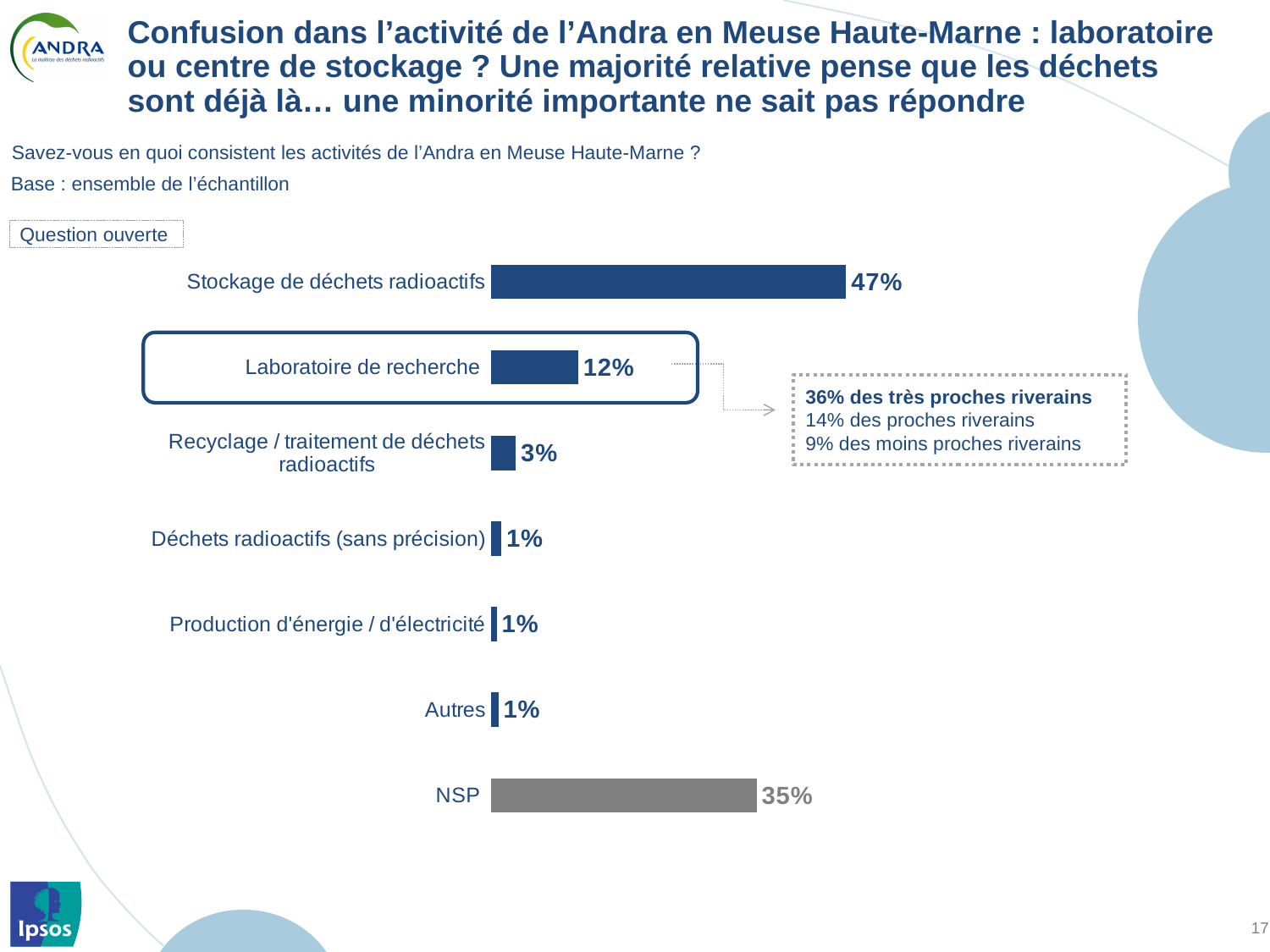
What is the difference between "Laboratoire de recherche" and "Recyclage / traitement de déchets radioactifs"? 9% Which is larger, "Laboratoire de recherche" or "NSP"? NSP What is the value for "Recyclage / traitement de déchets radioactifs"? 3% What is the value for "Laboratoire de recherche"? 12% Which category's bar is coloured grey rather than dark blue? NSP How many categories are shown in the chart? 7 What is the value for "Stockage de déchets radioactifs"? 47% What kind of chart is shown on the slide? Bar chart How many categories have a value of 1%? 3 What is the difference between "Stockage de déchets radioactifs" and "NSP"? 12% Which category has the highest value? Stockage de déchets radioactifs What is the value for "NSP"? 35%